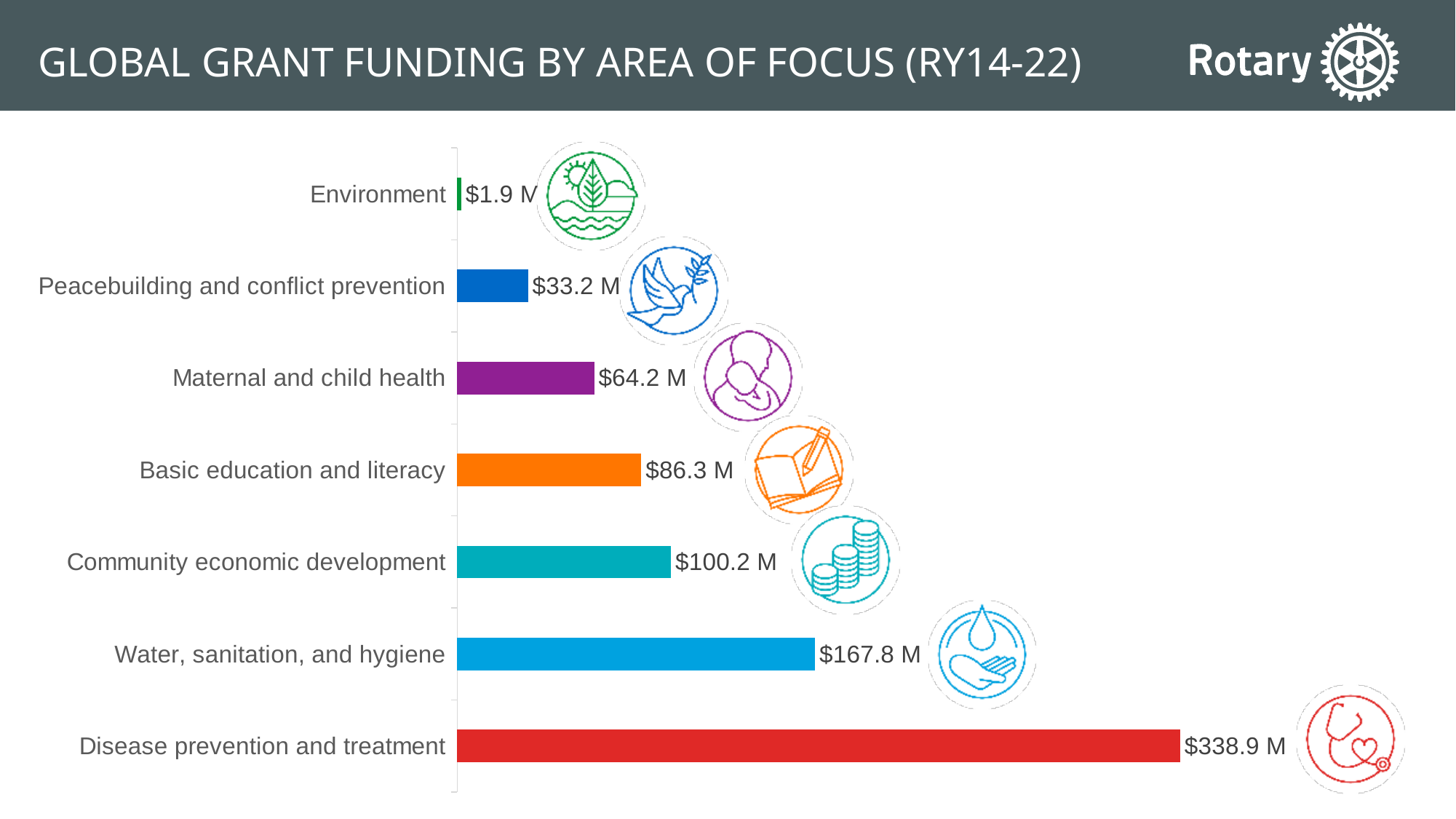
What is the title of the slide? GLOBAL GRANT FUNDING BY AREA OF FOCUS (RY14-22) What is the difference in funding between Community economic development and Basic education and literacy? $13.9 M What is the global grant funding value for Peacebuilding and conflict prevention? $33.2 M What kind of chart is shown on the slide? Bar chart Which received more funding, Basic education and literacy or Maternal and child health? Basic education and literacy Which area of focus received the highest global grant funding? Disease prevention and treatment How many areas of focus are shown in the chart? 7 What colour is the bar for Disease prevention and treatment? Red What is the difference in funding between Disease prevention and treatment and Water, sanitation, and hygiene? $171.1 M What is the global grant funding value for Maternal and child health? $64.2 M What is the global grant funding value for Water, sanitation, and hygiene? $167.8 M Which area of focus received the lowest global grant funding? Environment